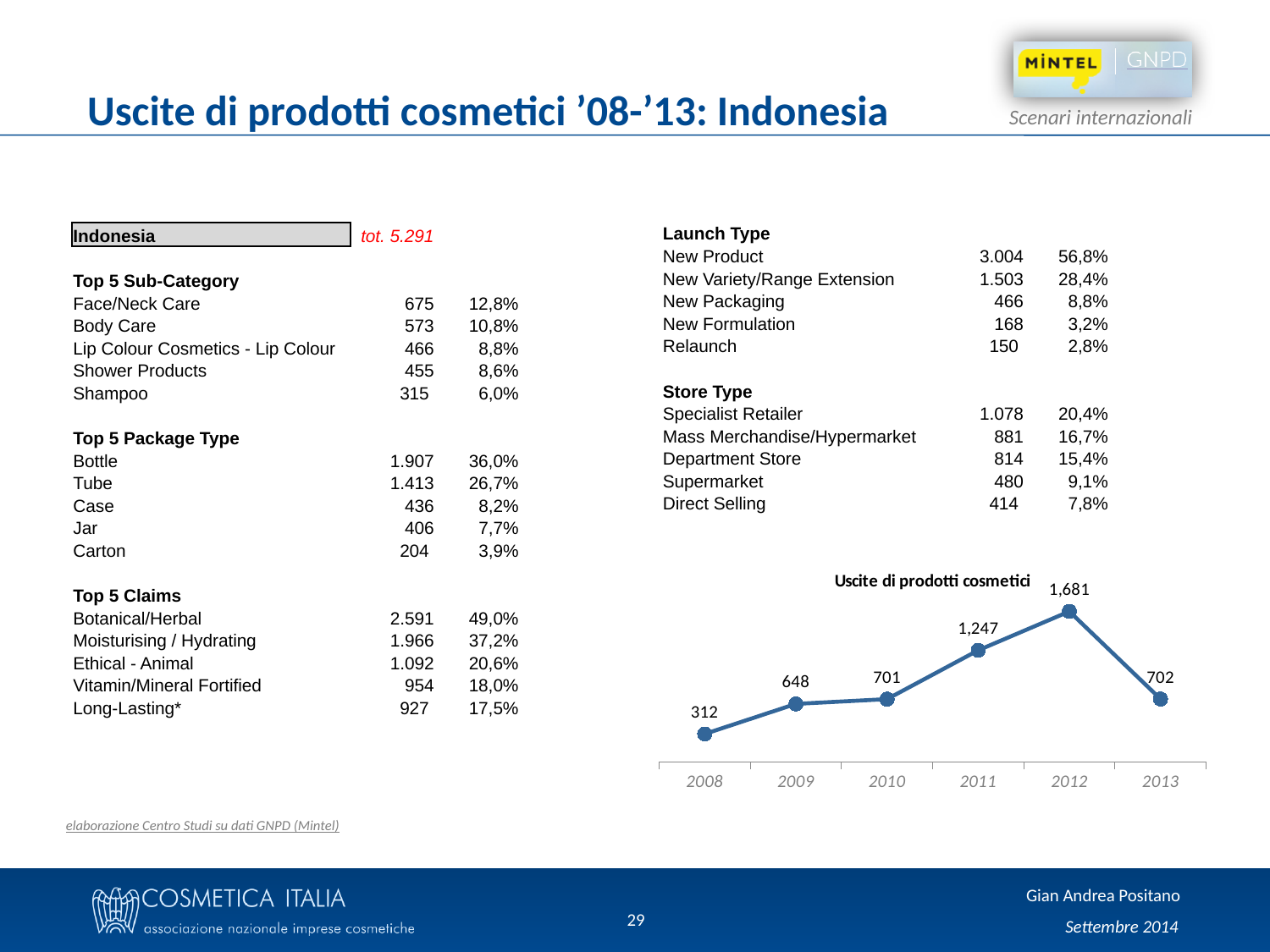
Does the value rise or fall from 2008 to 2012? rise Which is larger, the value for 2010 or the value for 2013? 2013 Which year has the lowest value in the chart? 2008 What is the difference between the values for 2012 and 2013? 979 What is the value for 2011 in the chart? 1,247 What is the value for 2008 in the chart? 312 How many years are plotted in the chart? 6 What is the title of the chart? Uscite di prodotti cosmetici What is the value for 2013 in the chart? 702 Which year has the highest value in the chart? 2012 What type of chart is shown on the slide? line chart What is the difference between the values for 2009 and 2010? 53